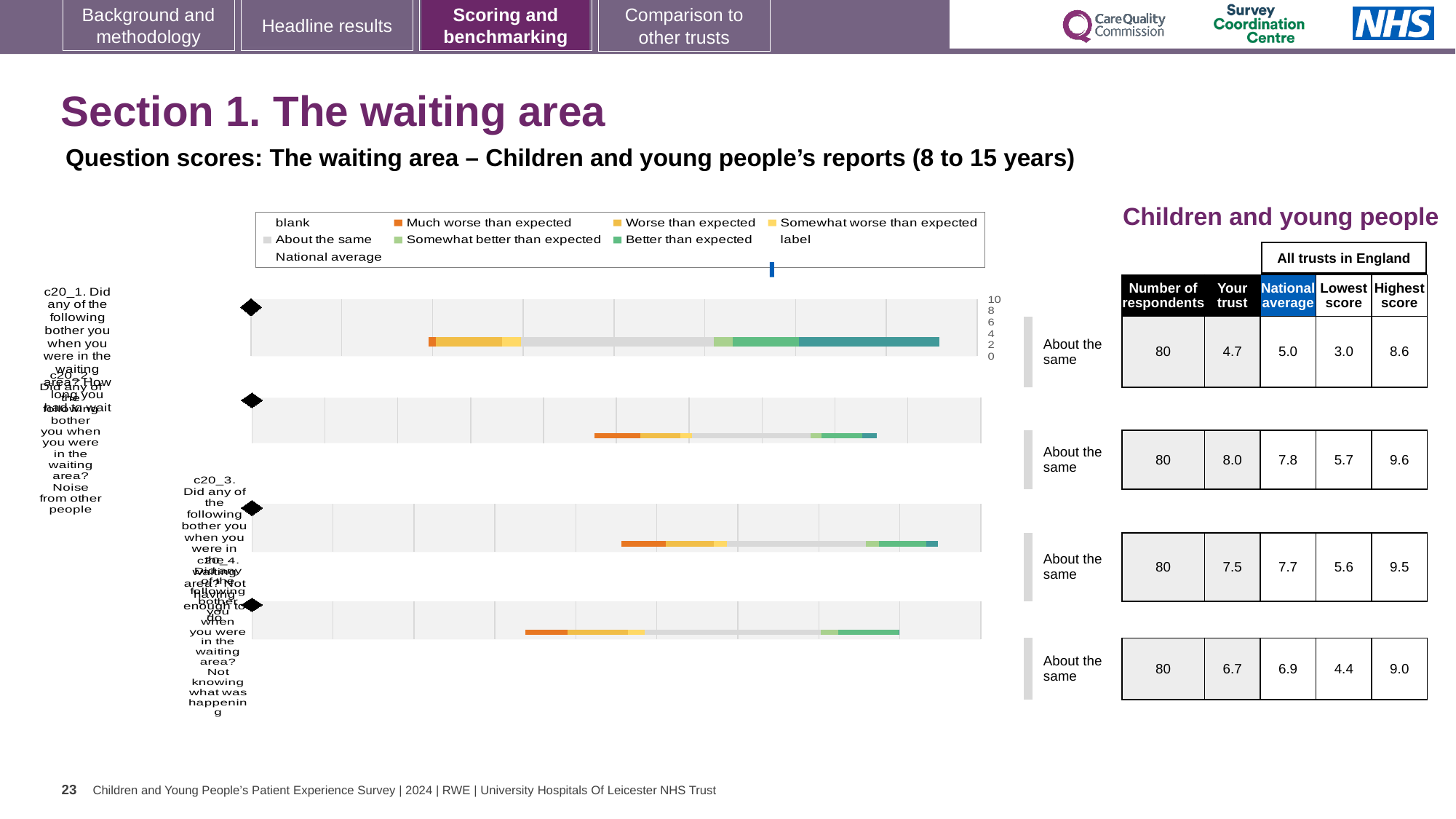
What is the highest value shown on the chart's axis scale? 10 What benchmark category is shown next to the bar for question c20_4? About the same How many horizontal bars (questions) are plotted in the chart? 4 What benchmark category is shown next to the bar for question c20_1? About the same Which legend entry is shown in light grey in the chart? About the same Which legend entry is shown in orange in the chart? Much worse than expected How many entries does the chart legend list? 9 What kind of chart is shown on the slide? bar chart